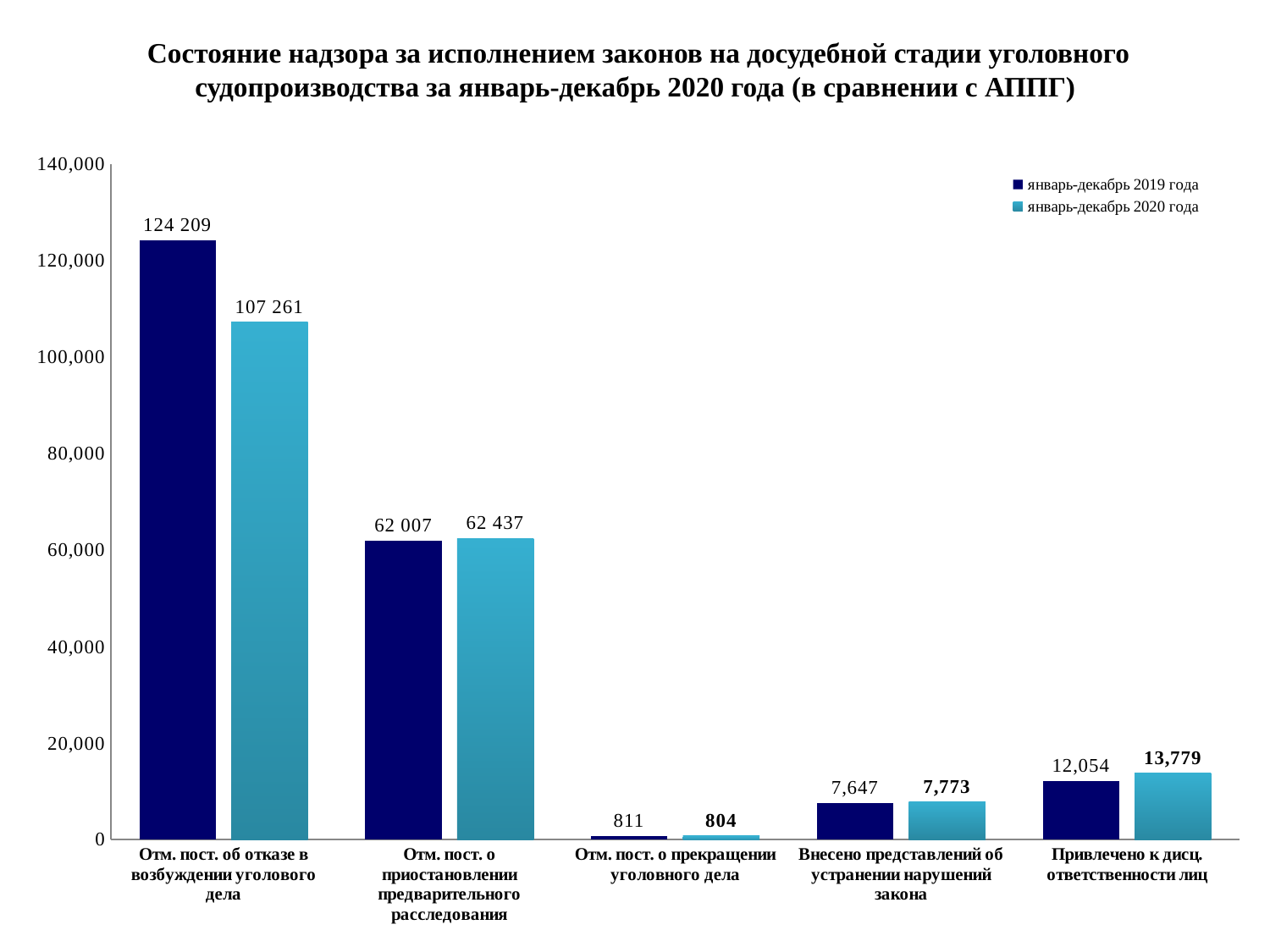
What is the value for "Отм. пост. об отказе в возбуждении уголового дела" in the январь-декабрь 2019 года series? 124 209 For "Отм. пост. о приостановлении предварительного расследования", which series has the larger value, январь-декабрь 2019 года or январь-декабрь 2020 года? январь-декабрь 2020 года How many categories are shown on the x axis? 5 What is the difference between the 2019 and 2020 values for "Отм. пост. об отказе в возбуждении уголового дела"? 16 948 What is the difference between the 2020 and 2019 values for "Привлечено к дисц. ответственности лиц"? 1,725 How many series does the legend list? 2 What kind of chart is shown on the slide? Bar chart Which category has the lowest value in the январь-декабрь 2020 года series? Отм. пост. о прекращении уголовного дела What is the value for "Внесено представлений об устранении нарушений закона" in the январь-декабрь 2019 года series? 7,647 Which category has the highest value in the январь-декабрь 2019 года series? Отм. пост. об отказе в возбуждении уголового дела What is the value for "Привлечено к дисц. ответственности лиц" in the январь-декабрь 2020 года series? 13,779 What is the value for "Отм. пост. об отказе в возбуждении уголового дела" in the январь-декабрь 2020 года series? 107 261